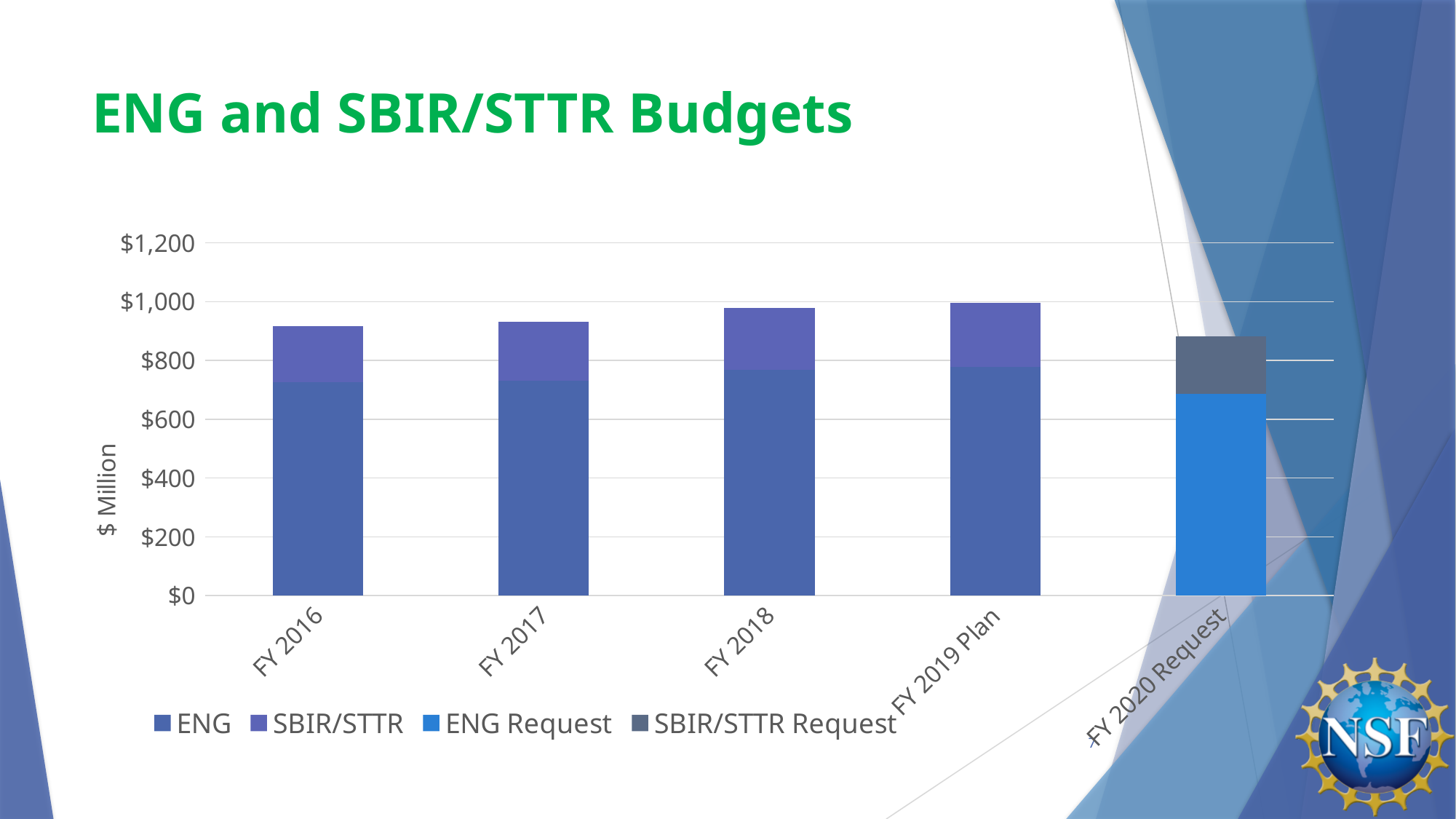
Is the ENG Request portion of the FY 2020 Request bar greater or less than $600? greater Which fiscal year has the lowest total bar? FY 2020 Request What is the title of the chart? ENG and SBIR/STTR Budgets What kind of chart is shown on the slide? Stacked bar chart What is the label on the vertical axis? $ Million How many series does the legend list? 4 Do the total bar heights rise or fall from FY 2016 to FY 2019 Plan? rise Is the total bar height for FY 2016 greater or less than $800? greater Is the total bar height for FY 2020 Request greater or less than $1,000? less Which total bar is taller, FY 2016 or FY 2019 Plan? FY 2019 Plan How many fiscal year categories are shown on the x axis? 5